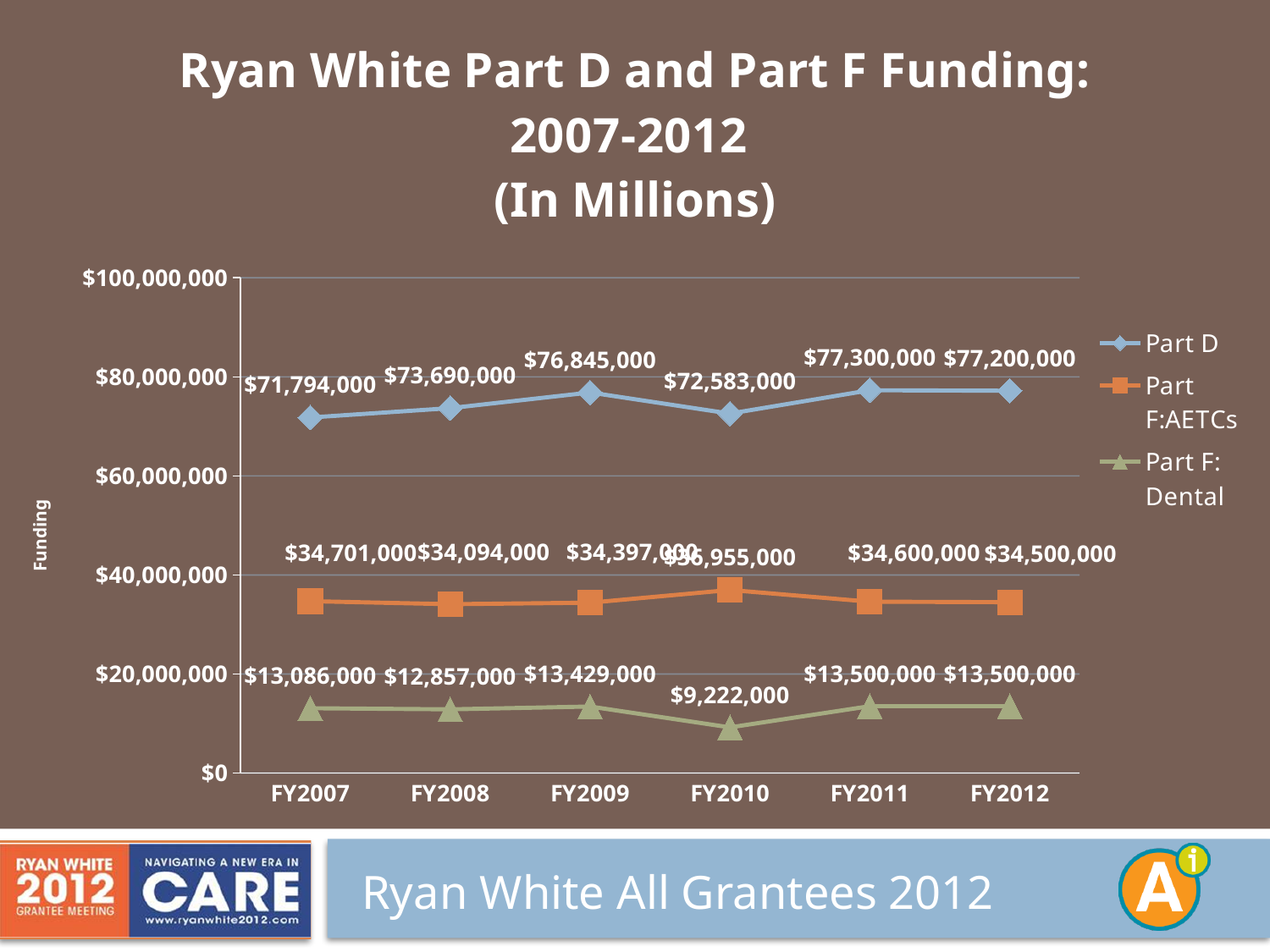
What is the Part F: Dental funding value for FY2010? $9,222,000 Is the Part D value for FY2007 greater or less than $80,000,000? less What kind of chart is shown on the slide? line chart What is the Part D funding value for FY2009? $76,845,000 What is the Part F:AETCs funding value for FY2007? $34,701,000 What is the difference between Part F: Dental funding in FY2011 and FY2010? $4,278,000 What is the difference between Part D funding in FY2009 and FY2007? $5,051,000 In which fiscal year is Part F: Dental funding lowest? FY2010 How many fiscal years are shown on the x axis? 6 How many series does the legend list? 3 Which is larger, Part D funding in FY2008 or Part D funding in FY2010? FY2008 In which fiscal year is Part D funding highest? FY2011